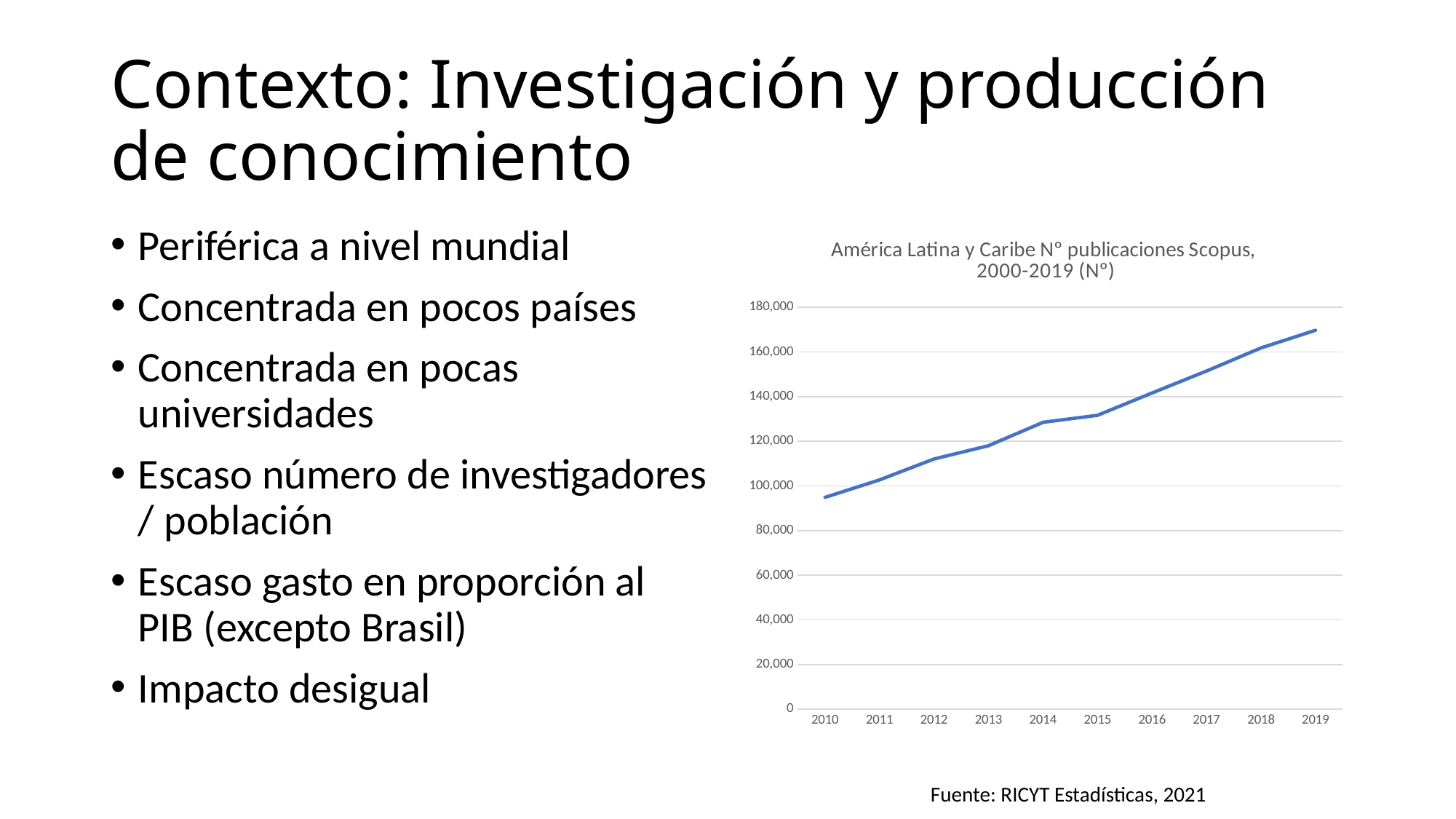
What kind of chart is shown on the slide? line chart Which year has the highest number of publications in the chart? 2019 What is the title of the chart? América Latina y Caribe N° publicaciones Scopus, 2000-2019 (N°) Which year has the lowest number of publications in the chart? 2010 Do the values in the chart rise or fall from 2010 to 2019? rise Is the value for 2019 greater or less than 160,000? greater Is the value for 2015 greater or less than 140,000? less Is the value for 2017 greater or less than 140,000? greater How many years are plotted on the x axis of the chart? 10 Which year has the larger value, 2012 or 2018? 2018